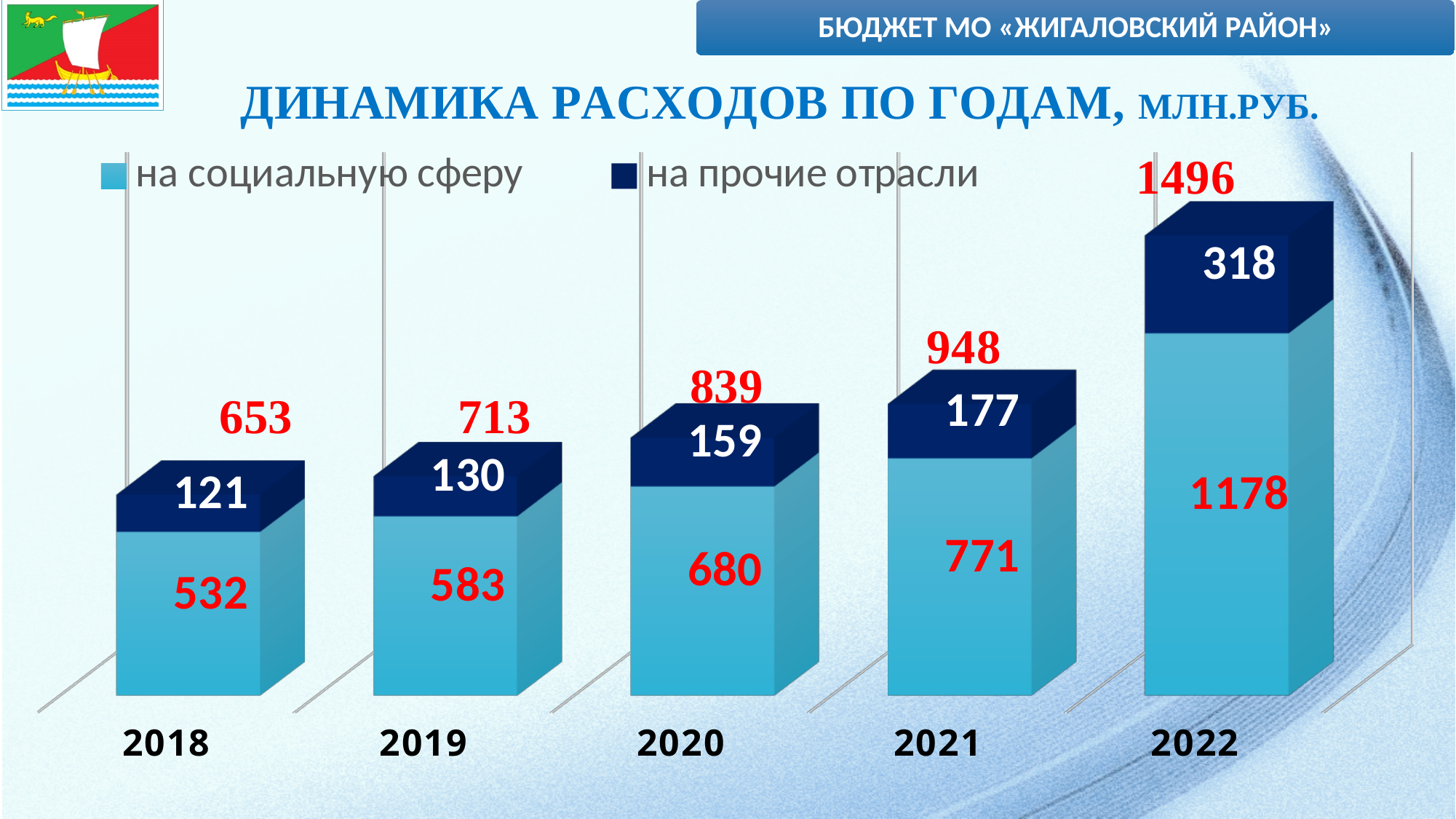
Which year has the highest total expenditure? 2022 What unit is given in the chart title? млн.руб. What kind of chart is shown on the slide? stacked bar chart How many years are shown on the x axis? 5 What is the value for "на прочие отрасли" in 2022? 318 How many series does the legend list? 2 What is the total of the stacked bar for 2021? 948 Which is larger: "на прочие отрасли" in 2019 or in 2020? 2020 What is the value for "на социальную сферу" in 2020? 680 Do the total expenditures rise or fall from 2018 to 2022? rise What is the difference between the "на социальную сферу" values for 2022 and 2021? 407 Which year has the lowest value for "на социальную сферу"? 2018